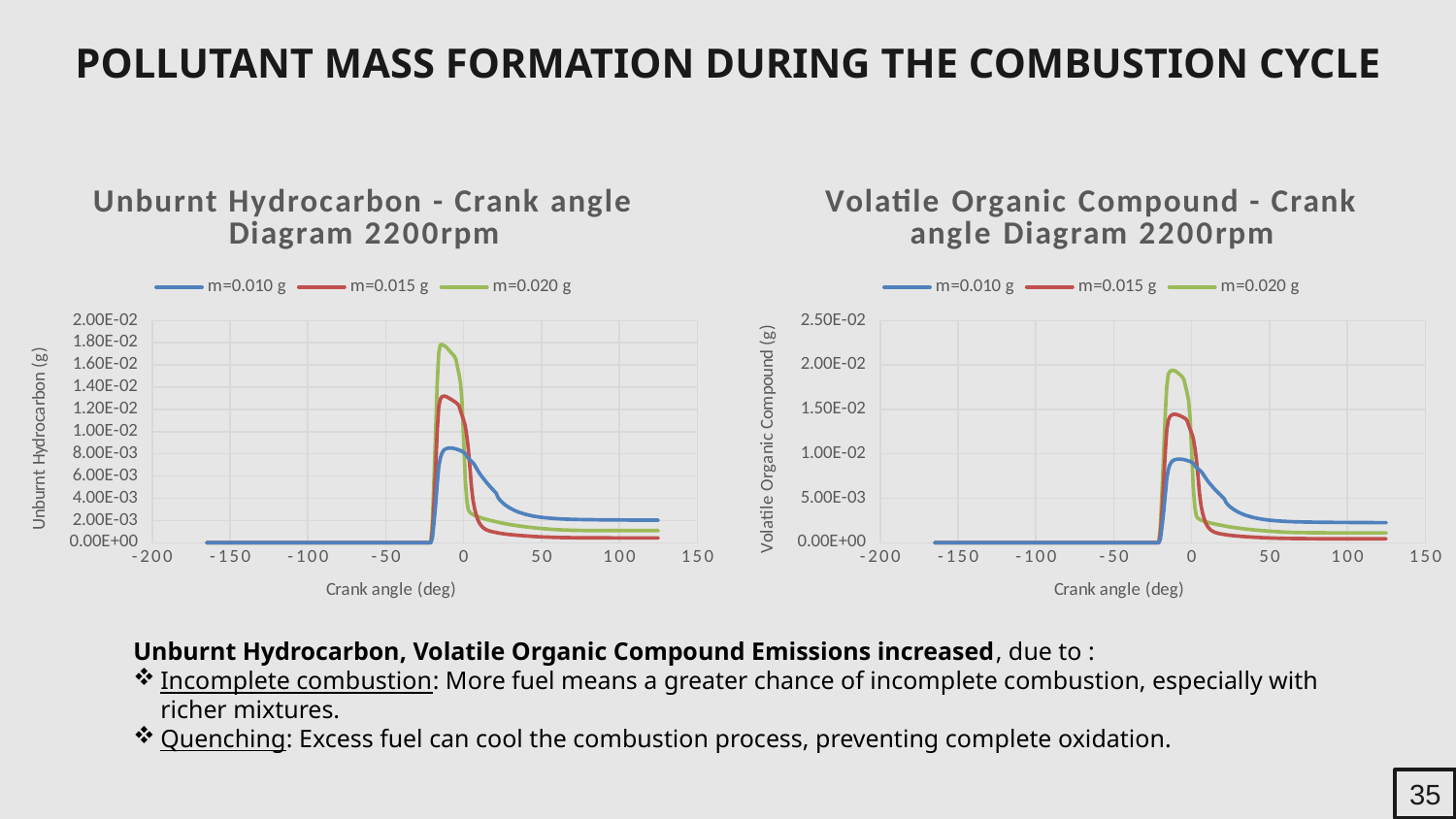
In the Volatile Organic Compound - Crank angle Diagram 2200rpm, after the peak near 0 degrees, do the values rise or fall as the crank angle increases toward 150? fall In the Unburnt Hydrocarbon - Crank angle Diagram 2200rpm, which series reaches the highest peak value? m=0.020 g In the Unburnt Hydrocarbon - Crank angle Diagram 2200rpm, is the peak value of the m=0.020 g series greater or less than 1.60E-02? greater What type of chart is the Unburnt Hydrocarbon - Crank angle Diagram 2200rpm? Line chart In the Volatile Organic Compound - Crank angle Diagram 2200rpm, which series reaches the highest peak value? m=0.020 g In the Unburnt Hydrocarbon - Crank angle Diagram 2200rpm, is the peak value of the m=0.010 g series greater or less than 1.00E-02? less How many series does the legend of the Volatile Organic Compound - Crank angle Diagram 2200rpm list? 3 What is the x-axis label of the Unburnt Hydrocarbon - Crank angle Diagram 2200rpm? Crank angle (deg) In the Volatile Organic Compound - Crank angle Diagram 2200rpm, which series has the lowest peak value? m=0.010 g In the Volatile Organic Compound - Crank angle Diagram 2200rpm, which series has the larger peak value, m=0.015 g or m=0.010 g? m=0.015 g In the Unburnt Hydrocarbon - Crank angle Diagram 2200rpm, which series has the lowest peak value? m=0.010 g In the Volatile Organic Compound - Crank angle Diagram 2200rpm, is the peak value of the m=0.020 g series greater or less than 1.50E-02? greater